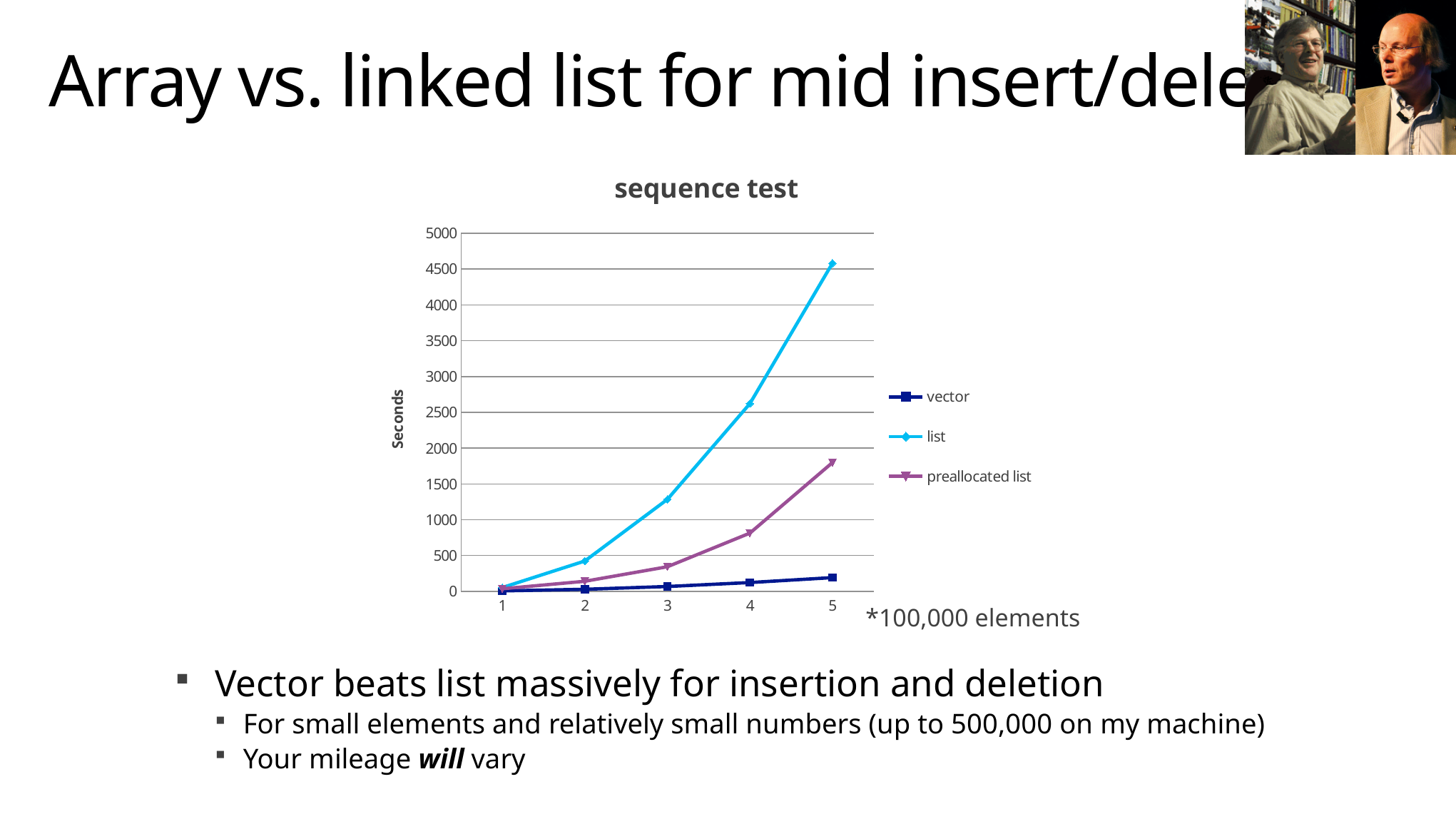
Is the value for vector at x = 5 greater or less than 500? less Is the value for list at x = 5 greater or less than 4000? greater Is the value for list at x = 3 greater or less than 1000? greater Which series has the highest value at x = 5? list Which series has the lowest value at x = 5? vector Do the values for the list series rise or fall as x increases from 1 to 5? rise How many series does the legend of the chart list? 3 What kind of chart is shown on the slide? line chart What is the title of the chart? sequence test How many points are plotted along the x axis for each series? 5 At x = 4, which series has the larger value, list or preallocated list? list